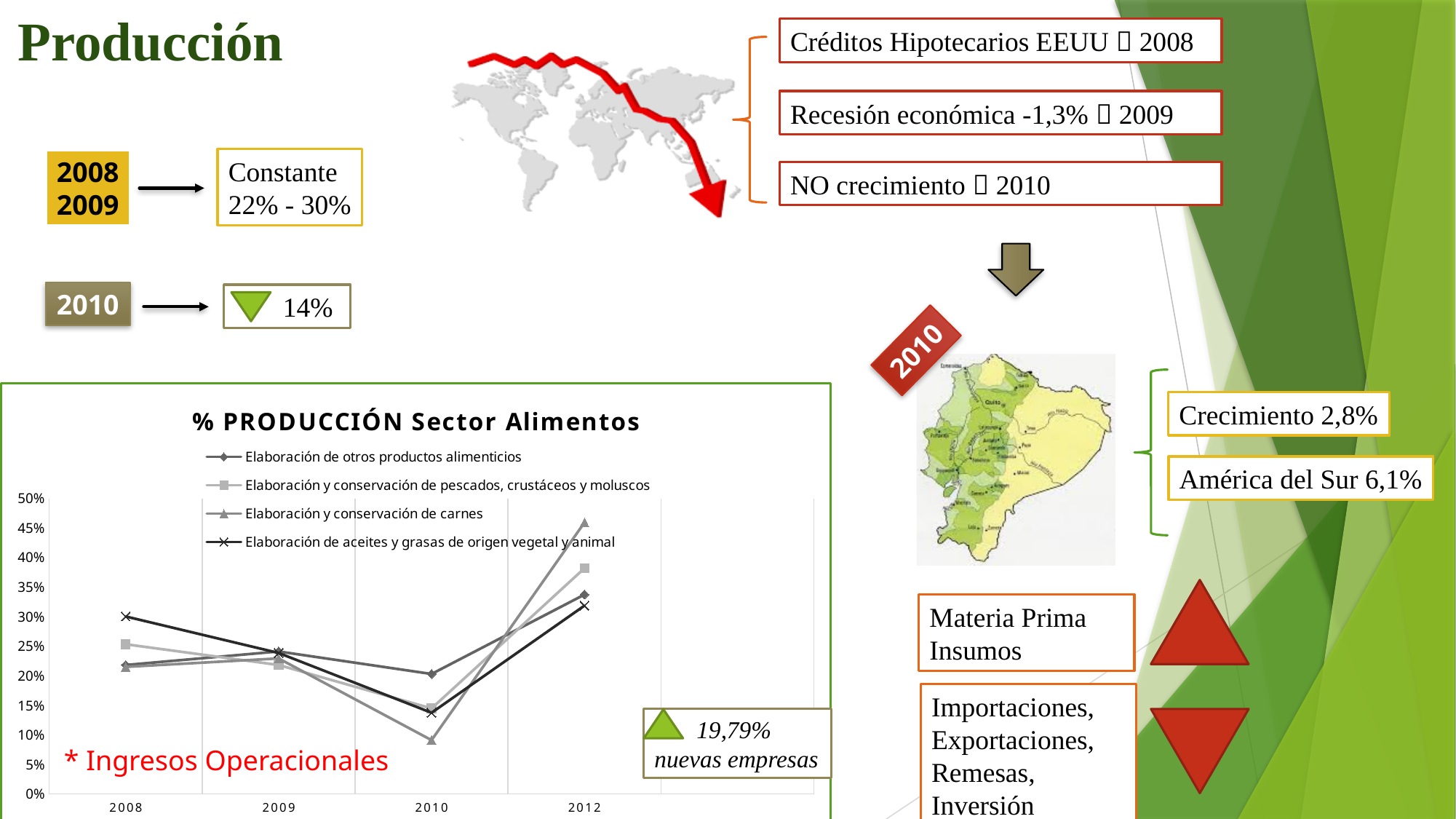
In the "% PRODUCCIÓN Sector Alimentos" chart, does the value for Elaboración y conservación de carnes rise or fall from 2010 to 2012? rise In the "% PRODUCCIÓN Sector Alimentos" chart, which is larger in 2012: Elaboración y conservación de pescados, crustáceos y moluscos or Elaboración de otros productos alimenticios? Elaboración y conservación de pescados, crustáceos y moluscos In the "% PRODUCCIÓN Sector Alimentos" chart, which series has the lowest value in 2010? Elaboración y conservación de carnes How many years are shown on the x axis of the "% PRODUCCIÓN Sector Alimentos" chart? 4 How many series does the legend of the "% PRODUCCIÓN Sector Alimentos" chart list? 4 What is the title of the line chart on the slide? % PRODUCCIÓN Sector Alimentos In the "% PRODUCCIÓN Sector Alimentos" chart, which series has the highest value in 2012? Elaboración y conservación de carnes In the "% PRODUCCIÓN Sector Alimentos" chart, is the 2012 value for Elaboración y conservación de carnes greater or less than 40%? greater In the "% PRODUCCIÓN Sector Alimentos" chart, which series has the highest value in 2008? Elaboración de aceites y grasas de origen vegetal y animal What kind of chart is "% PRODUCCIÓN Sector Alimentos"? line chart In the "% PRODUCCIÓN Sector Alimentos" chart, is the 2010 value for Elaboración y conservación de carnes greater or less than 10%? less In the "% PRODUCCIÓN Sector Alimentos" chart, is the 2008 value for Elaboración de aceites y grasas de origen vegetal y animal greater or less than 25%? greater